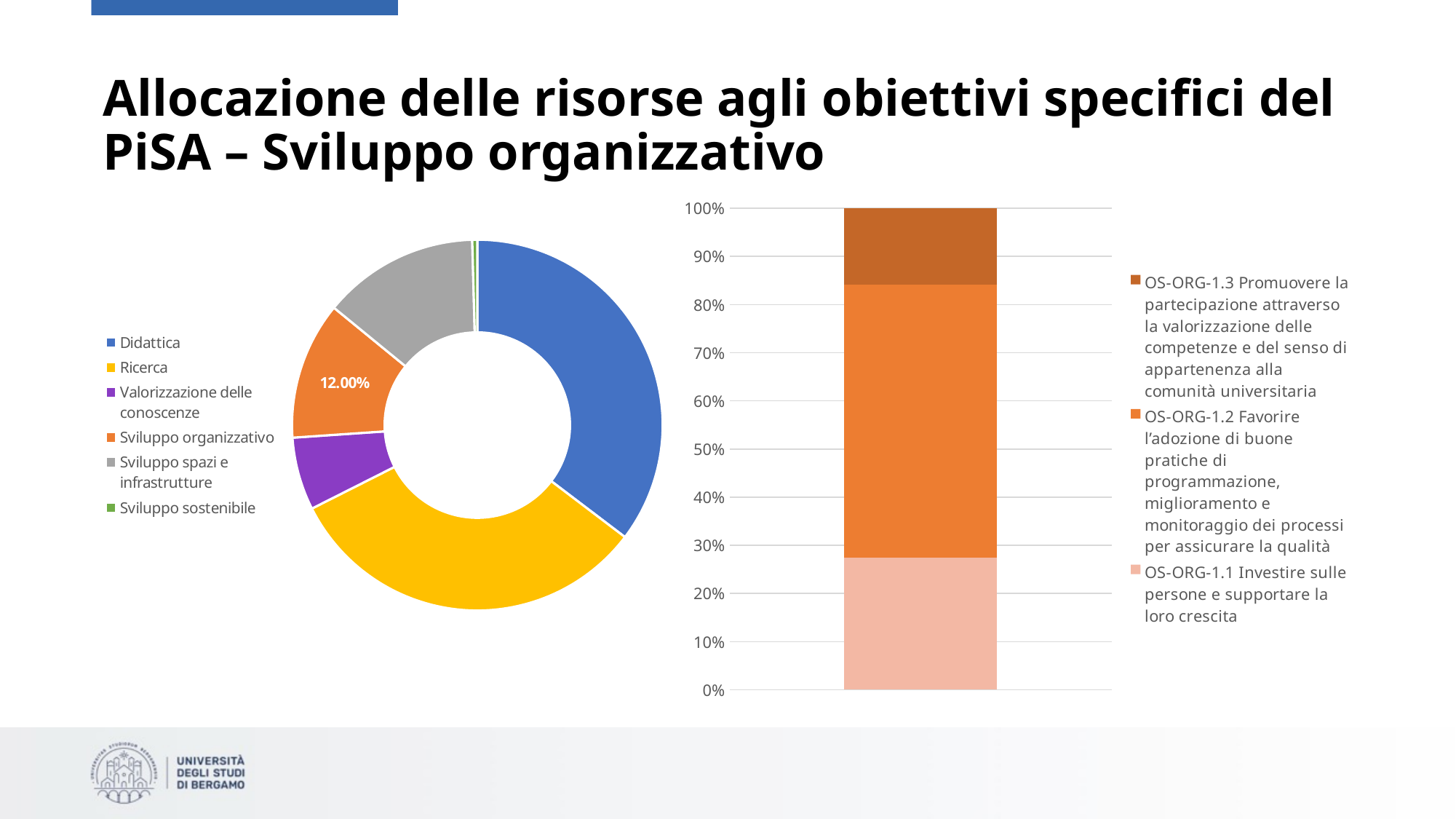
In the doughnut chart on the left, which category has the largest slice? Didattica In the doughnut chart on the left, what colour represents Didattica? blue In the stacked bar chart on the right, is the value for OS-ORG-1.2 Favorire l'adozione di buone pratiche greater or less than 50%? greater In the doughnut chart on the left, which slice is larger: Sviluppo spazi e infrastrutture or Valorizzazione delle conoscenze? Sviluppo spazi e infrastrutture In the stacked bar chart on the right, which series takes the largest share of the bar? OS-ORG-1.2 Favorire l'adozione di buone pratiche di programmazione, miglioramento e monitoraggio dei processi per assicurare la qualità In the doughnut chart on the left, which category has the smallest slice? Sviluppo sostenibile What kind of chart is the chart on the right of the slide? stacked bar chart In the doughnut chart on the left, what percentage is shown for Sviluppo organizzativo? 12.00% How many categories does the legend of the doughnut chart on the left list? 6 How many series does the legend of the stacked bar chart on the right list? 3 In the stacked bar chart on the right, is the value for OS-ORG-1.1 Investire sulle persone e supportare la loro crescita greater or less than 30%? less What kind of chart is the chart on the left of the slide? doughnut chart